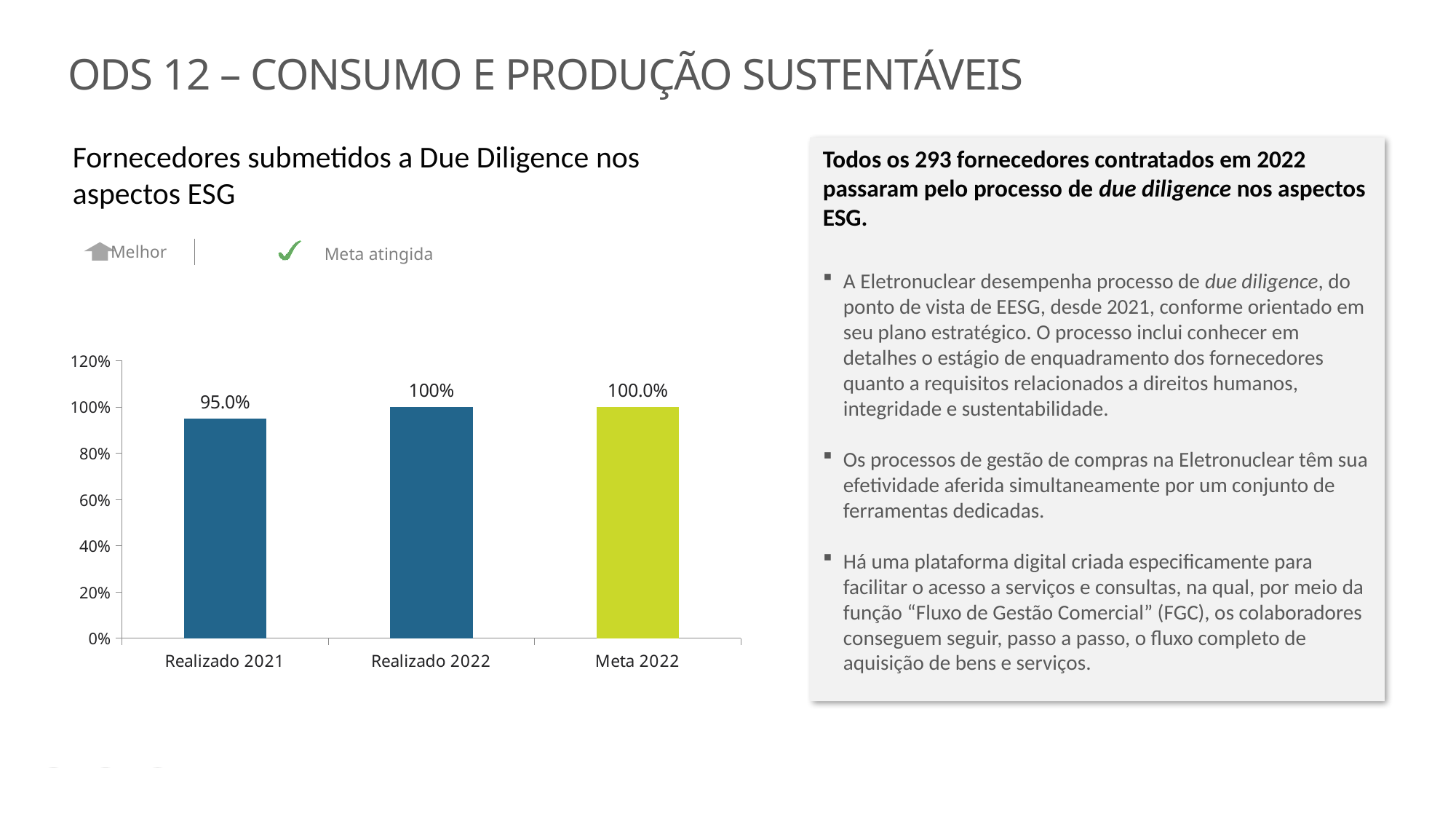
How many categories are shown on the x axis? 3 What is the title of the chart? Fornecedores submetidos a Due Diligence nos aspectos ESG What is the value for Meta 2022? 100.0% Which is larger, the value for Realizado 2021 or the value for Realizado 2022? Realizado 2022 What is the difference between the values for Realizado 2022 and Realizado 2021? 5.0% Which category has the lowest value? Realizado 2021 What is the value for Realizado 2022? 100% Which bar is shown in a different colour (yellow-green) from the others? Meta 2022 Do the values rise or fall from Realizado 2021 to Realizado 2022? rise What kind of chart is shown on the slide? bar chart What is the value for Realizado 2021? 95.0% Is the value for Realizado 2021 greater or less than 80%? greater